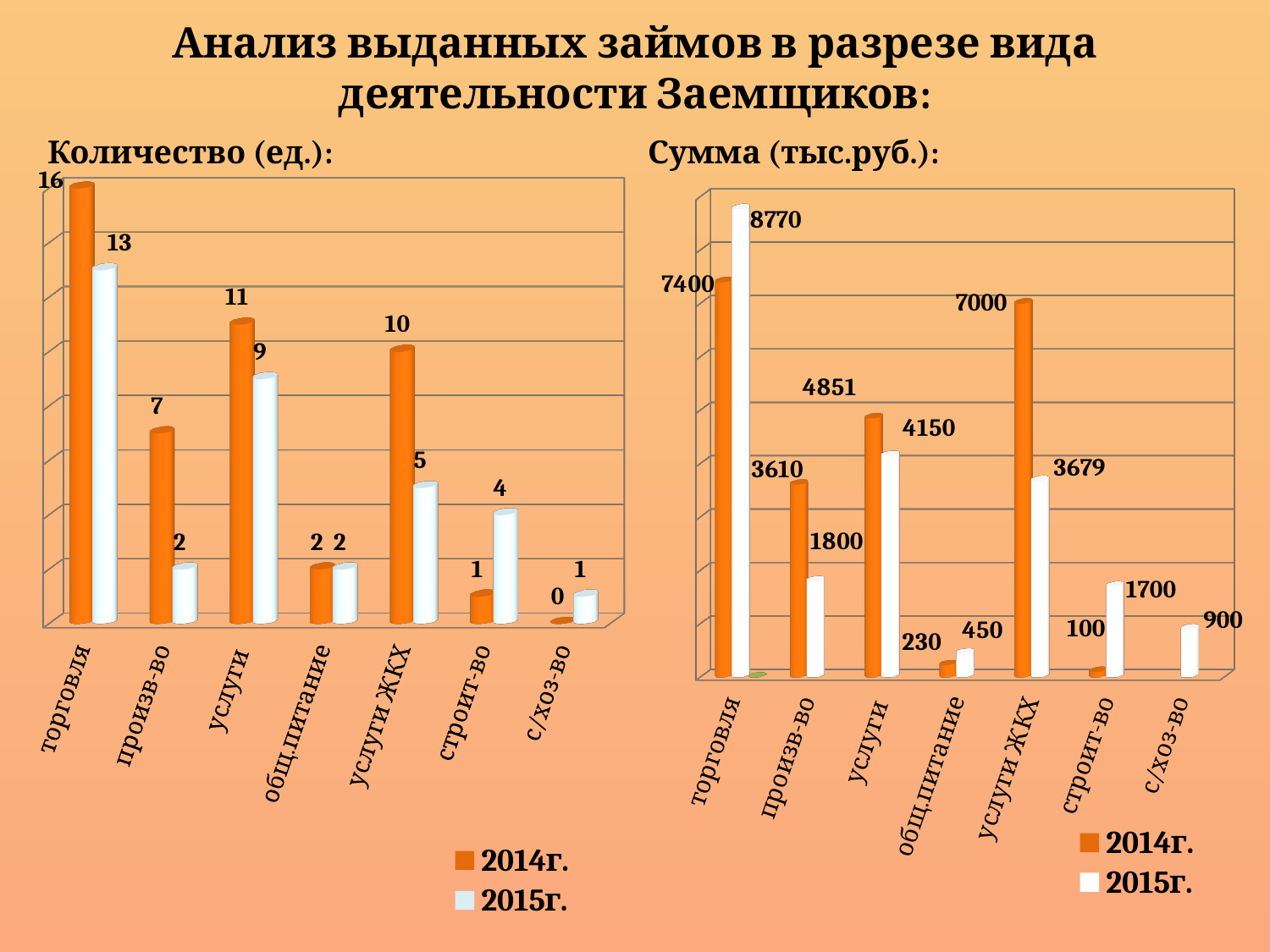
In the 'Количество (ед.)' chart, which is larger for строит-во: the 2014г. value or the 2015г. value? 2015г. In the 'Количество (ед.)' chart, what is the difference between the 2014г. and 2015г. values for произв-во? 5 In the 'Количество (ед.)' chart, which category has the highest value for 2014г.? торговля How many categories are shown on the x axis of the 'Количество (ед.)' chart? 7 In the 'Сумма (тыс.руб.)' chart, what is the value for торговля in 2015г.? 8770 In the 'Количество (ед.)' chart, what is the value for торговля in 2014г.? 16 What type of chart is the 'Сумма (тыс.руб.)' chart? bar chart In the 'Сумма (тыс.руб.)' chart, what is the value for услуги ЖКХ in 2014г.? 7000 In the 'Сумма (тыс.руб.)' chart, which is larger for услуги: the 2014г. value or the 2015г. value? 2014г. In the 'Сумма (тыс.руб.)' chart, which category has the lowest value for 2014г.? строит-во In the 'Количество (ед.)' chart, what is the value for услуги ЖКХ in 2015г.? 5 In the 'Сумма (тыс.руб.)' chart, what is the difference between the 2015г. and 2014г. values for торговля? 1370